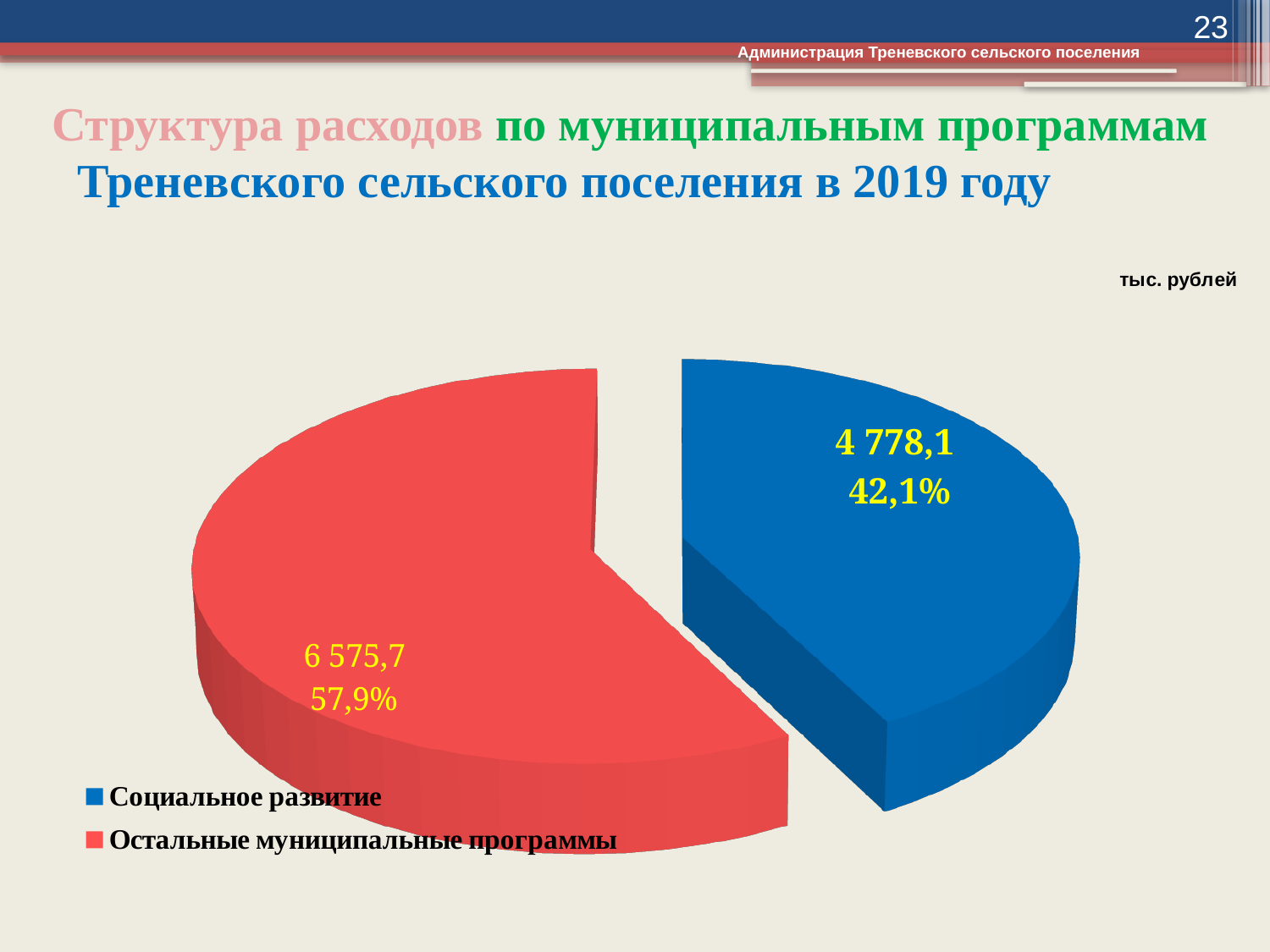
What is the value for Социальное развитие? 4 778,1 What type of chart is shown on the slide? pie chart What is the total of the two slices in the pie chart? 11 353,8 Which category has the smallest slice of the pie? Социальное развитие How many slices does the pie chart have? 2 What colour is the slice for Социальное развитие? blue Which category has the largest slice of the pie? Остальные муниципальные программы What is the value for Остальные муниципальные программы? 6 575,7 What is the difference between the values for Остальные муниципальные программы and Социальное развитие? 1 797,6 What share of the pie does Остальные муниципальные программы represent? 57,9% What share of the pie does Социальное развитие represent? 42,1% Which is larger: Социальное развитие or Остальные муниципальные программы? Остальные муниципальные программы